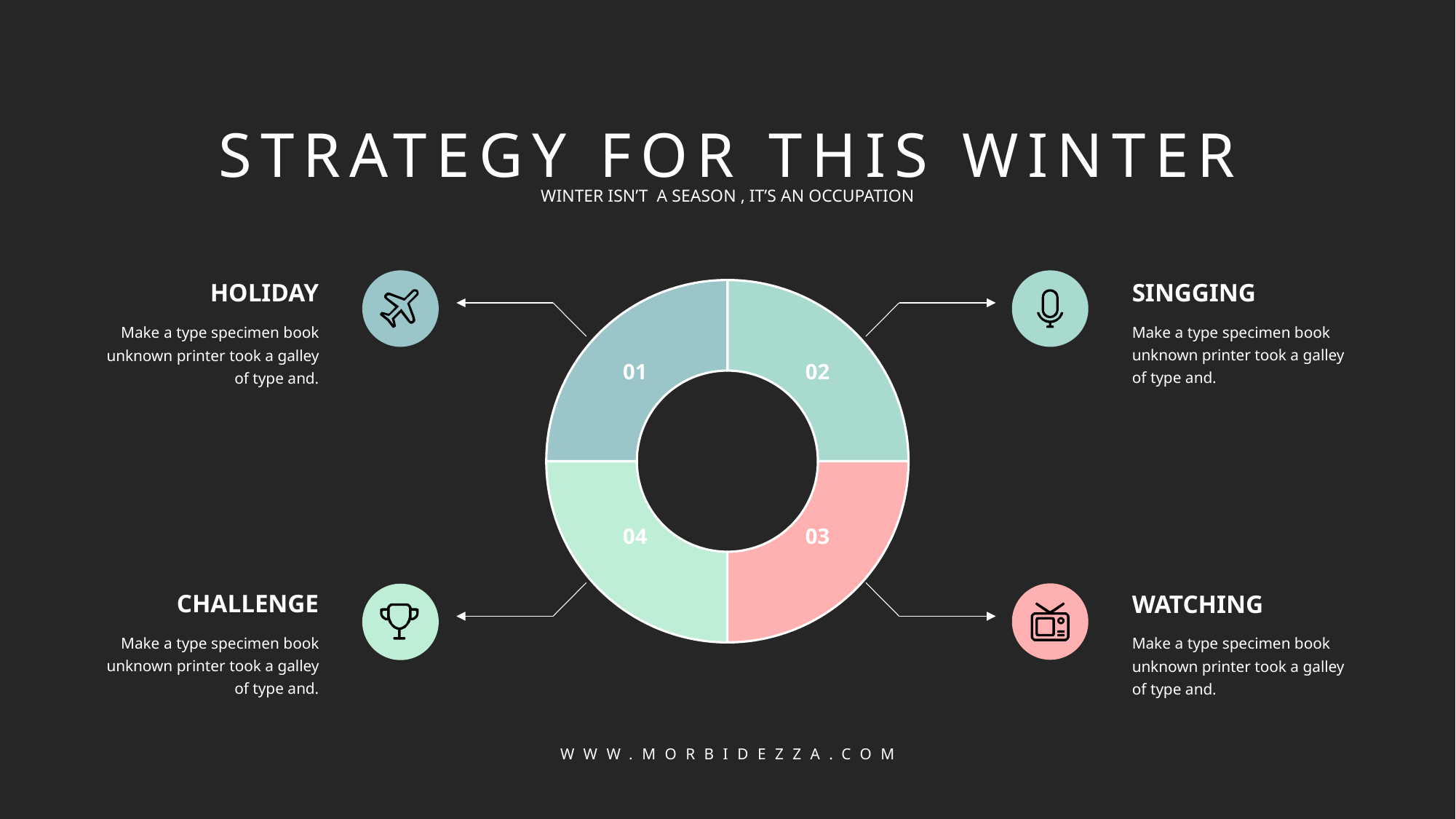
What kind of chart is shown in the centre of the slide? Donut (pie) chart Which strategy item is connected to segment 02 of the donut chart? SINGGING Which strategy item is connected to segment 04 of the donut chart? CHALLENGE Which segment label is printed on the top-left segment of the donut chart? 01 How many segments does the donut chart have? 4 What label is printed on the pink segment of the donut chart? 03